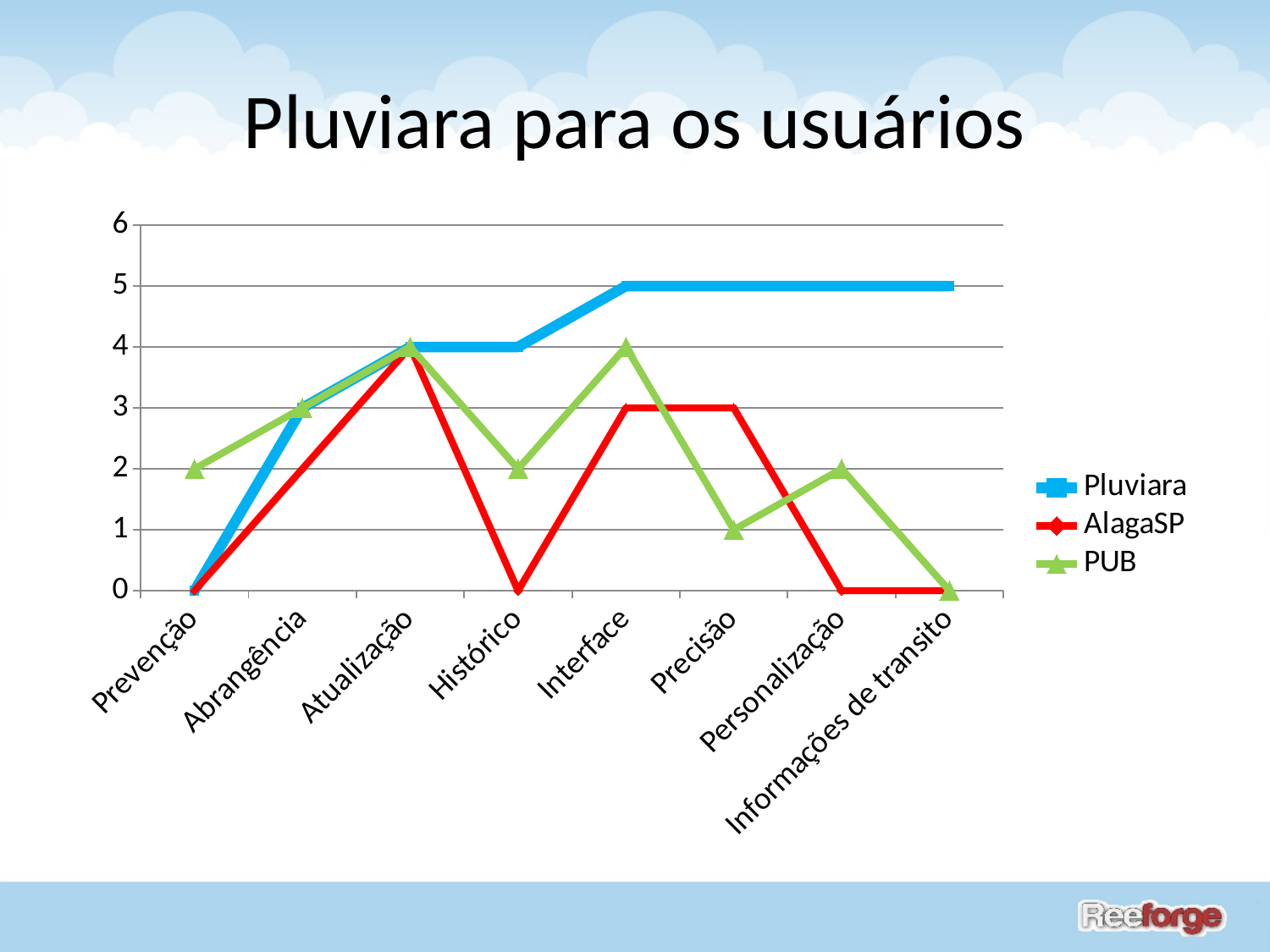
Which series has the lowest value at Prevenção? Pluviara and AlagaSP (both 0) What is the value for PUB at Precisão? 1 What kind of chart is shown on the slide? line chart What is the difference between Pluviara and PUB at Precisão? 4 What is the value for AlagaSP at Histórico? 0 What is the value for Pluviara at Interface? 5 What is the title of the chart? Pluviara para os usuários Which is larger at Histórico, the value for Pluviara or the value for PUB? Pluviara How many series does the legend list? 3 Which series has the highest value at Personalização? Pluviara How many categories are shown on the x axis? 8 What is the value for PUB at Prevenção? 2